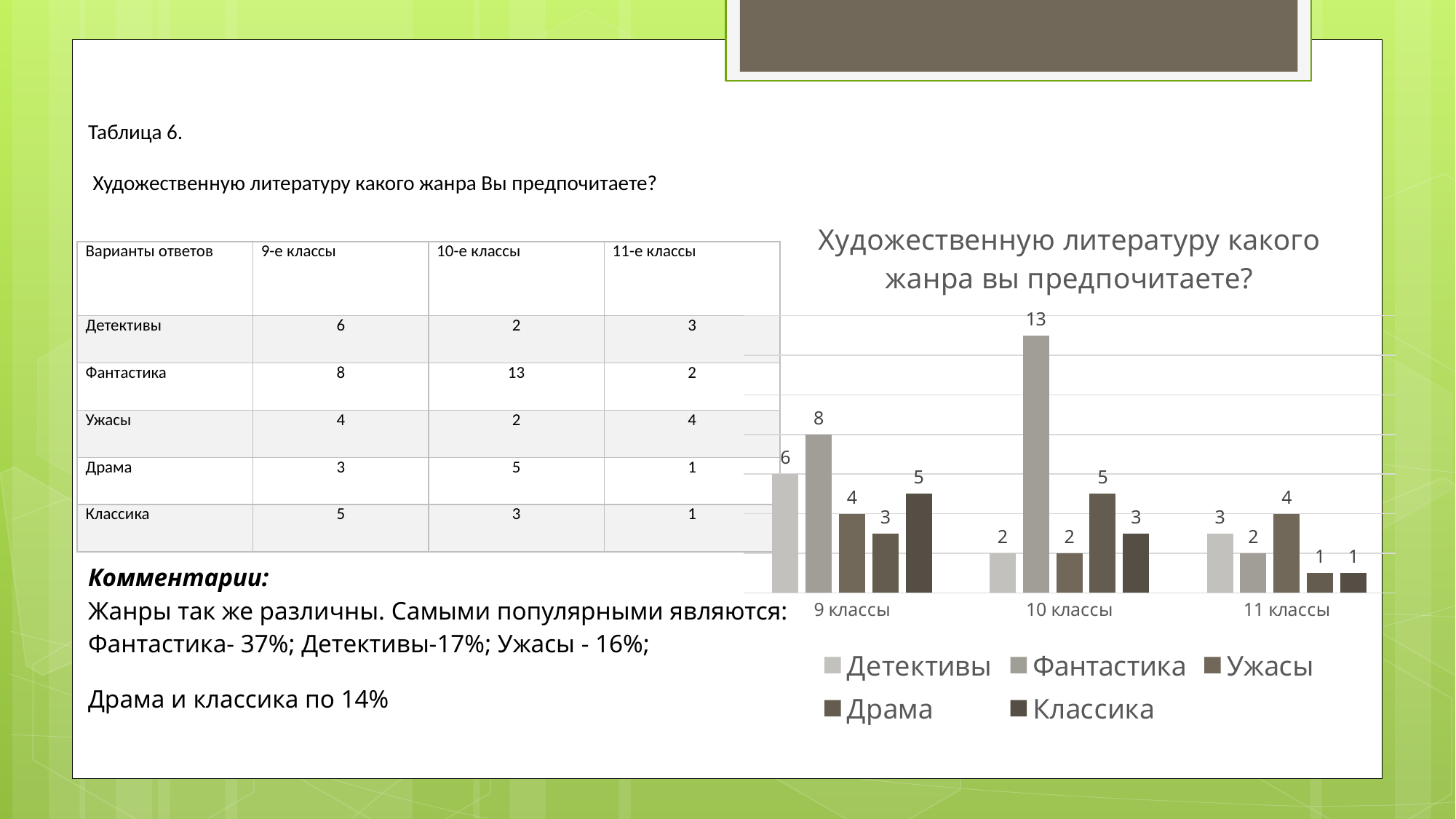
How many class groups (categories) are shown on the x axis of the chart? 3 How many series does the chart legend list? 5 Which is larger: Драма in 10 классы or Драма in 11 классы? Драма in 10 классы What is the value for Ужасы in 11 классы? 4 What is the value for Классика in 11 классы? 1 What is the difference between Фантастика in 10 классы and Фантастика in 9 классы? 5 Which genre has the lowest value in 10 классы? Детективы and Ужасы (both 2) What is the value for Фантастика in 10 классы? 13 What kind of chart is shown on the slide? bar chart What is the title of the chart? Художественную литературу какого жанра вы предпочитаете? Which genre has the highest value in 9 классы? Фантастика What is the value for Детективы in 9 классы? 6